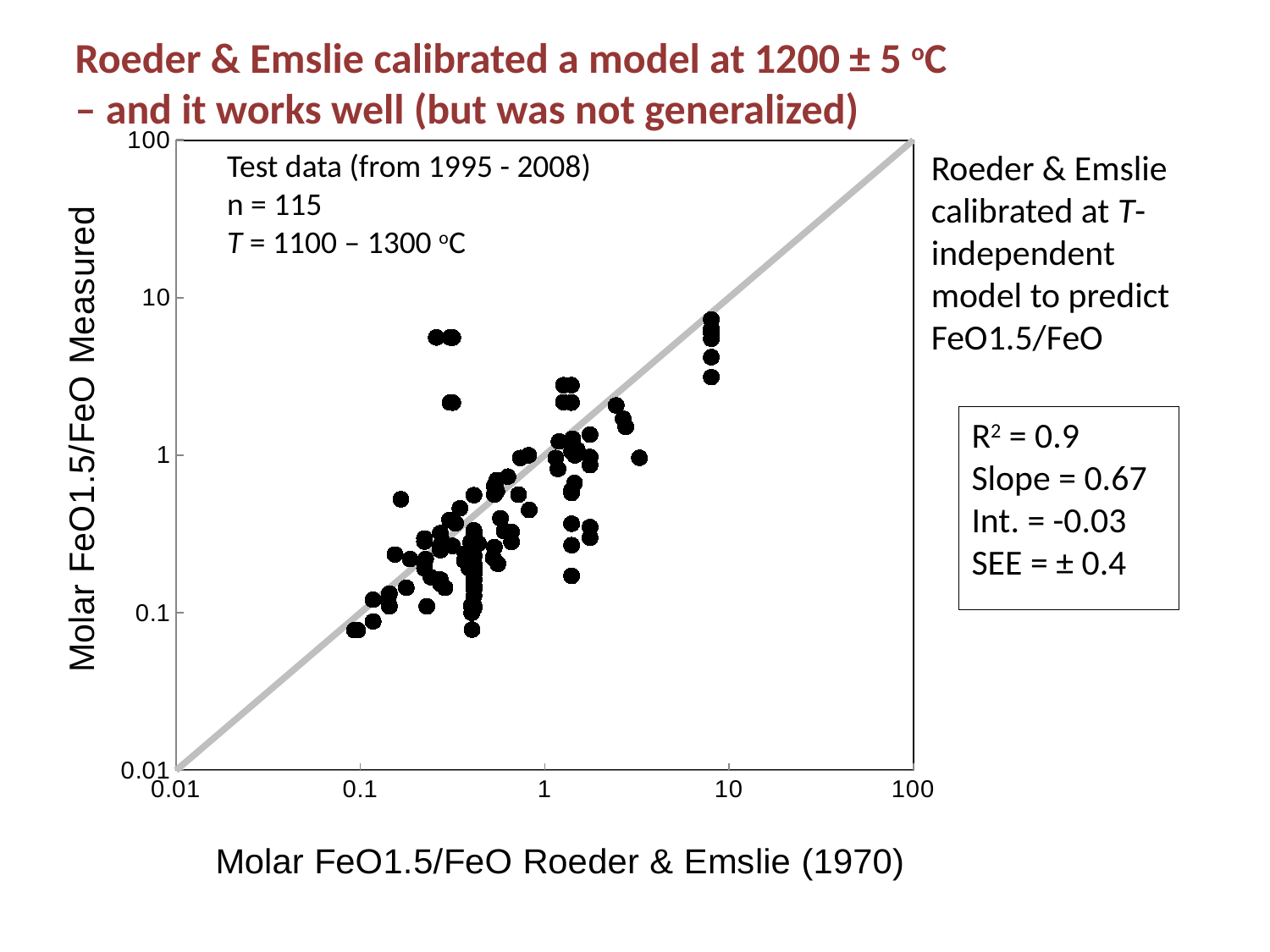
What is the R² value reported for the model on the chart? 0.9 Is the highest measured value plotted on the chart greater or less than 10? less What is the label of the x axis? Molar FeO1.5/FeO Roeder & Emslie (1970) What temperature range does the annotation give for the test data? 1100 – 1300 °C What kind of chart is shown on the slide? Scatter plot What slope is reported in the statistics box on the chart? 0.67 What intercept (Int.) is reported in the statistics box on the chart? -0.03 How many test data points are plotted, according to the annotation on the chart? 115 Do the measured values generally rise or fall as the Roeder & Emslie (1970) values increase along the x axis? Rise From which years does the annotation say the test data come? 1995 - 2008 What is the maximum value shown on the y axis? 100 What SEE value is reported in the statistics box on the chart? ± 0.4